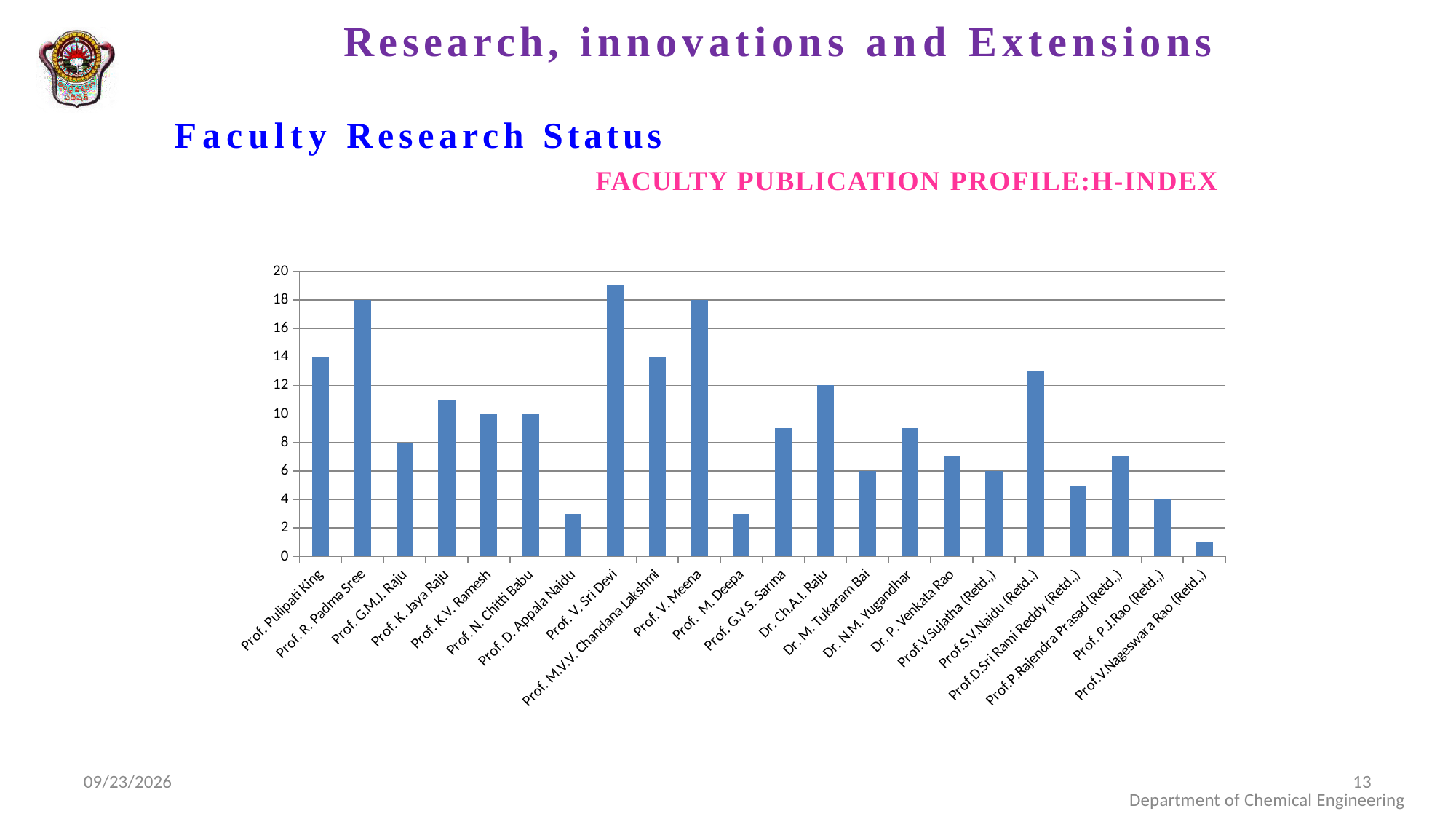
How many faculty members are plotted on the chart? 22 What kind of chart is shown on the slide? bar chart Is the value for Prof. K. Jaya Raju greater or less than 10? greater What is the H-index value for Prof. Pulipati King? 14 Which faculty member has the lowest H-index on the chart? Prof.V.Nageswara Rao (Retd.,) Which faculty member has the highest H-index on the chart? Prof. V. Sri Devi Which is larger, the H-index of Prof. V. Meena or that of Prof. M. Deepa? Prof. V. Meena What is the H-index value for Dr. Ch.A.I. Raju? 12 Is the value for Prof. D. Appala Naidu greater or less than 4? less What is the H-index value for Prof. R. Padma Sree? 18 What is the H-index value for Prof. G.M.J. Raju? 8 What is the title of the chart? FACULTY PUBLICATION PROFILE:H-INDEX